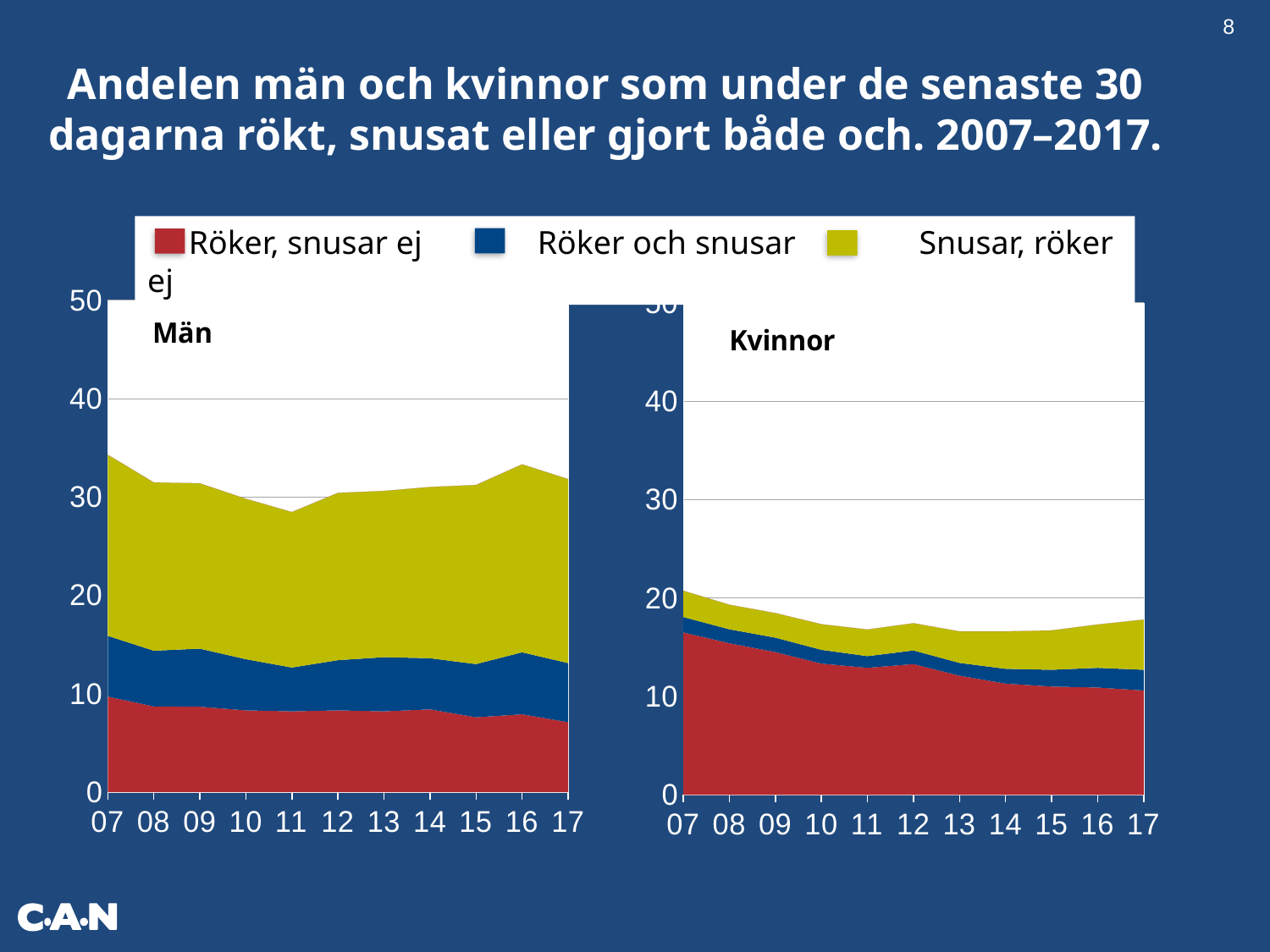
What kind of chart is used for the Män chart on the left? Stacked area chart In the Män chart, is the value of the Röker, snusar ej series for 17 greater or less than 10? less How many years are plotted along the x axis of the Kvinnor chart? 11 In the Kvinnor chart, is the value of the Röker, snusar ej series for 07 greater or less than 10? greater In the Kvinnor chart, is the total stacked value for 17 greater or less than 20? less Which series is shown in yellow in the legend? Snusar, röker ej How many series does the legend list? 3 Does the total stacked value in the Kvinnor chart rise or fall from 07 to 17? fall Which chart has the larger total stacked value for 07, Män or Kvinnor? Män What is the title of the chart on the right? Kvinnor